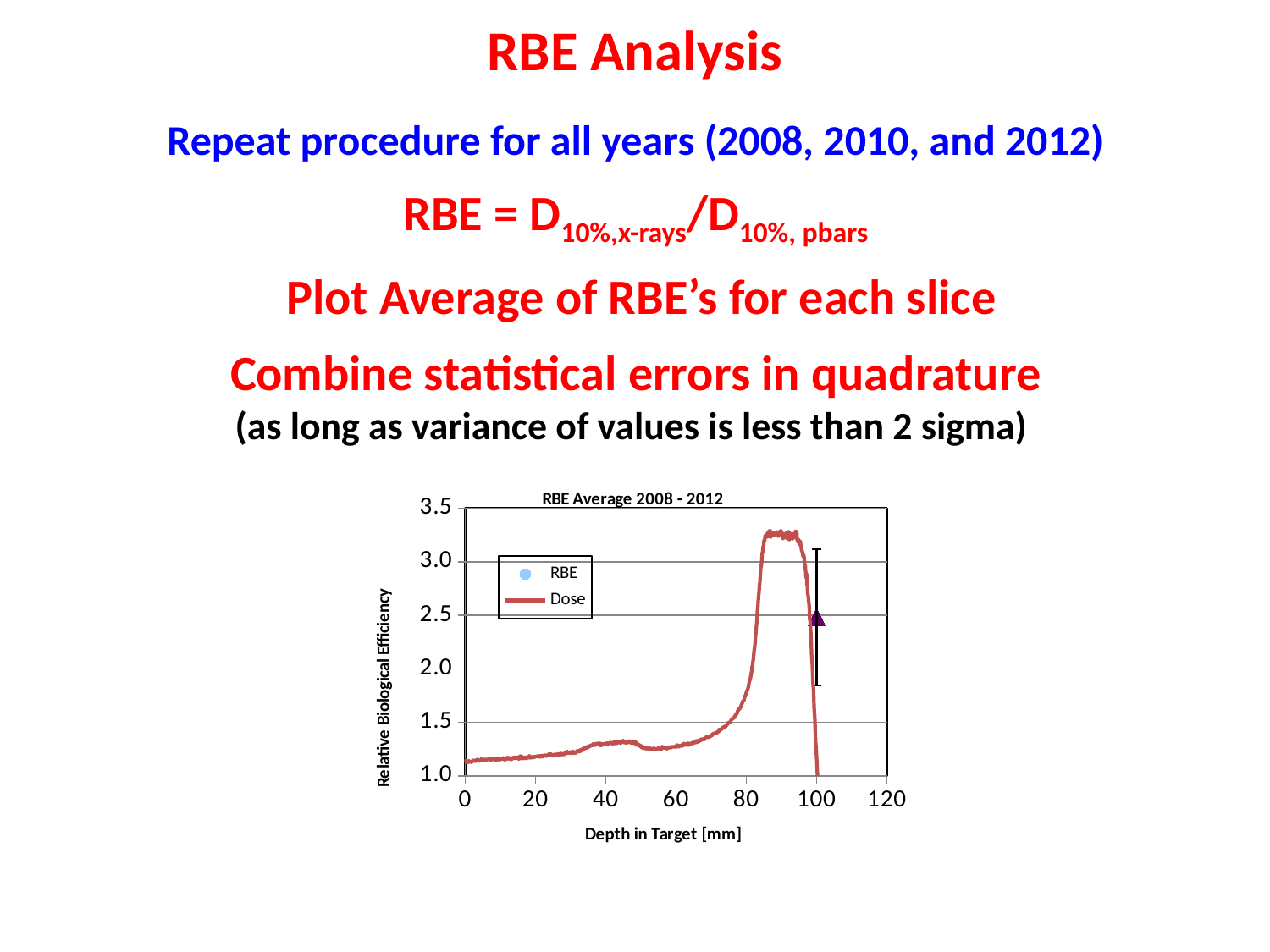
Is the RBE data point plotted near 100 mm greater or less than 3.0? less Is the Dose value at a depth of 0 mm greater or less than 1.5? less What is the title of the chart on the slide? RBE Average 2008 - 2012 Which is larger: the Dose value at 90 mm or the Dose value at 20 mm? Dose at 90 mm What kind of chart is shown on the slide? line chart What are the two series named in the chart legend? RBE and Dose Is the Dose value at a depth of 60 mm greater or less than 2.0? less How many series does the chart legend list? 2 Between depths of 0 mm and 80 mm, does the Dose curve rise or fall? rise What is the label of the x axis of the chart? Depth in Target [mm]